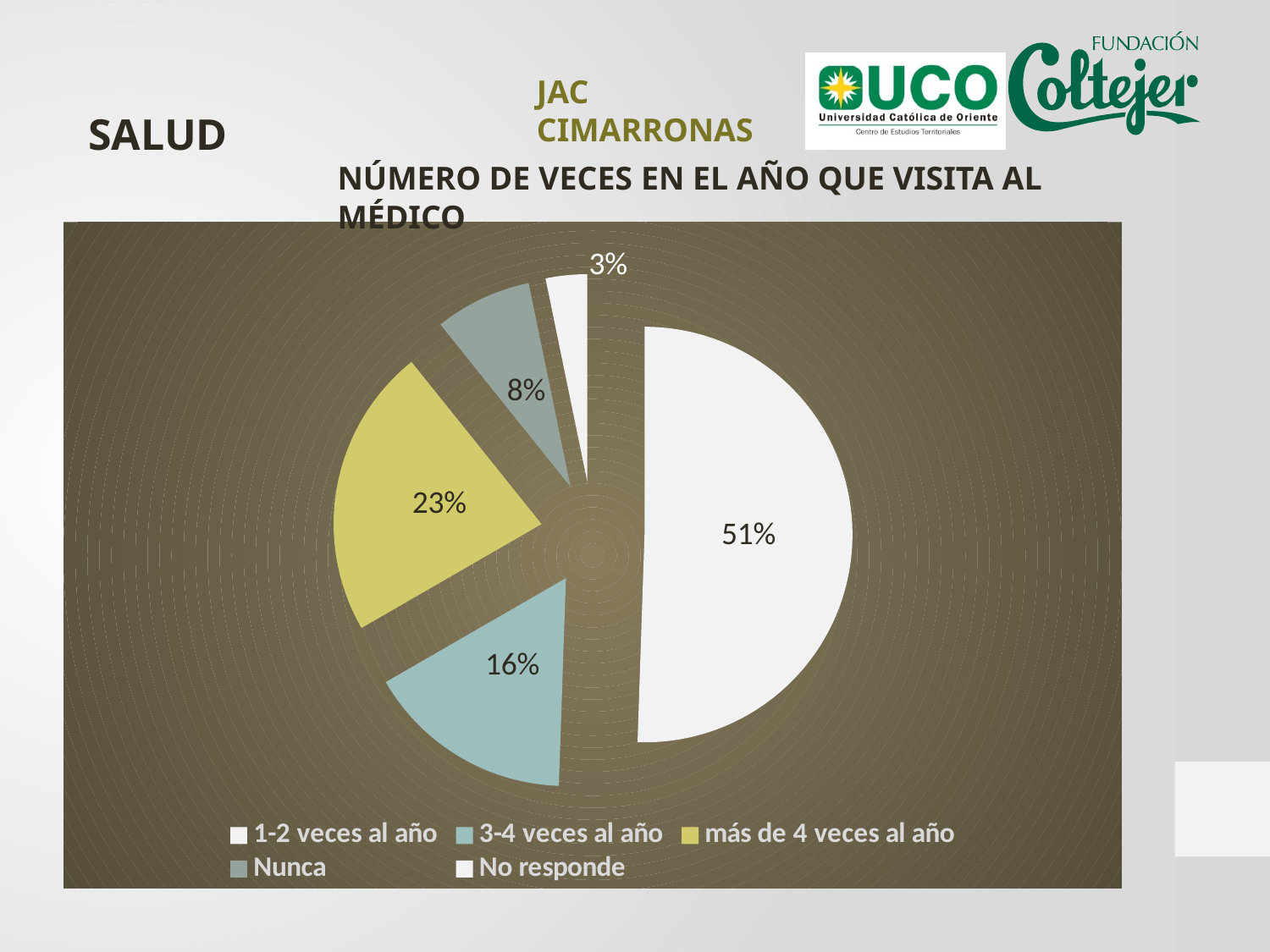
What kind of chart is shown on the slide? pie chart What percentage corresponds to 'más de 4 veces al año'? 23% What percentage is shown for '3-4 veces al año'? 16% How many categories does the legend of the pie chart list? 5 Which category has the largest slice of the pie? 1-2 veces al año What is the difference in percentage points between '1-2 veces al año' and 'más de 4 veces al año'? 28 Which category has the smallest slice of the pie? No responde What percentage of respondents visit the doctor 1-2 veces al año? 51% What is the title of the chart? NÚMERO DE VECES EN EL AÑO QUE VISITA AL MÉDICO What percentage is shown for 'No responde'? 3% What share of the pie is labelled 'Nunca'? 8% Which is larger, the slice for '3-4 veces al año' or the slice for 'Nunca'? 3-4 veces al año